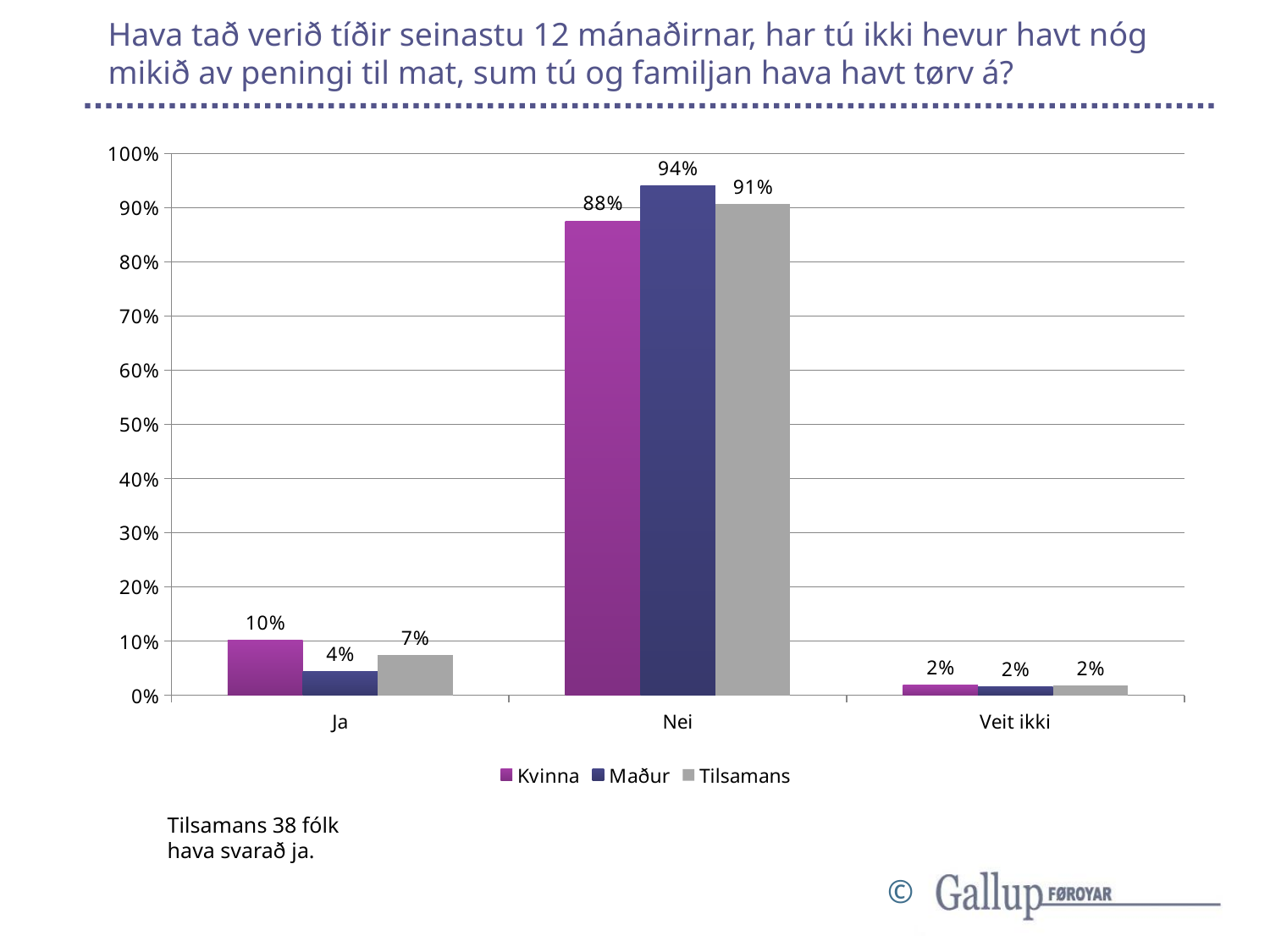
How many series does the legend list? 3 What kind of chart is shown on the slide? Bar chart Which category has the lowest value for the Tilsamans series? Veit ikki What is the value for Maður in the Ja category? 4% What is the value for Maður in the Nei category? 94% Which category has the highest value for the Kvinna series? Nei Which series is shown in grey in the legend? Tilsamans What is the value for Tilsamans in the Nei category? 91% What is the difference between the Kvinna and Maður values in the Ja category? 6% In the Nei category, which is larger, the Kvinna value or the Maður value? Maður How many categories are shown on the x axis? 3 What is the value for Kvinna in the Ja category? 10%